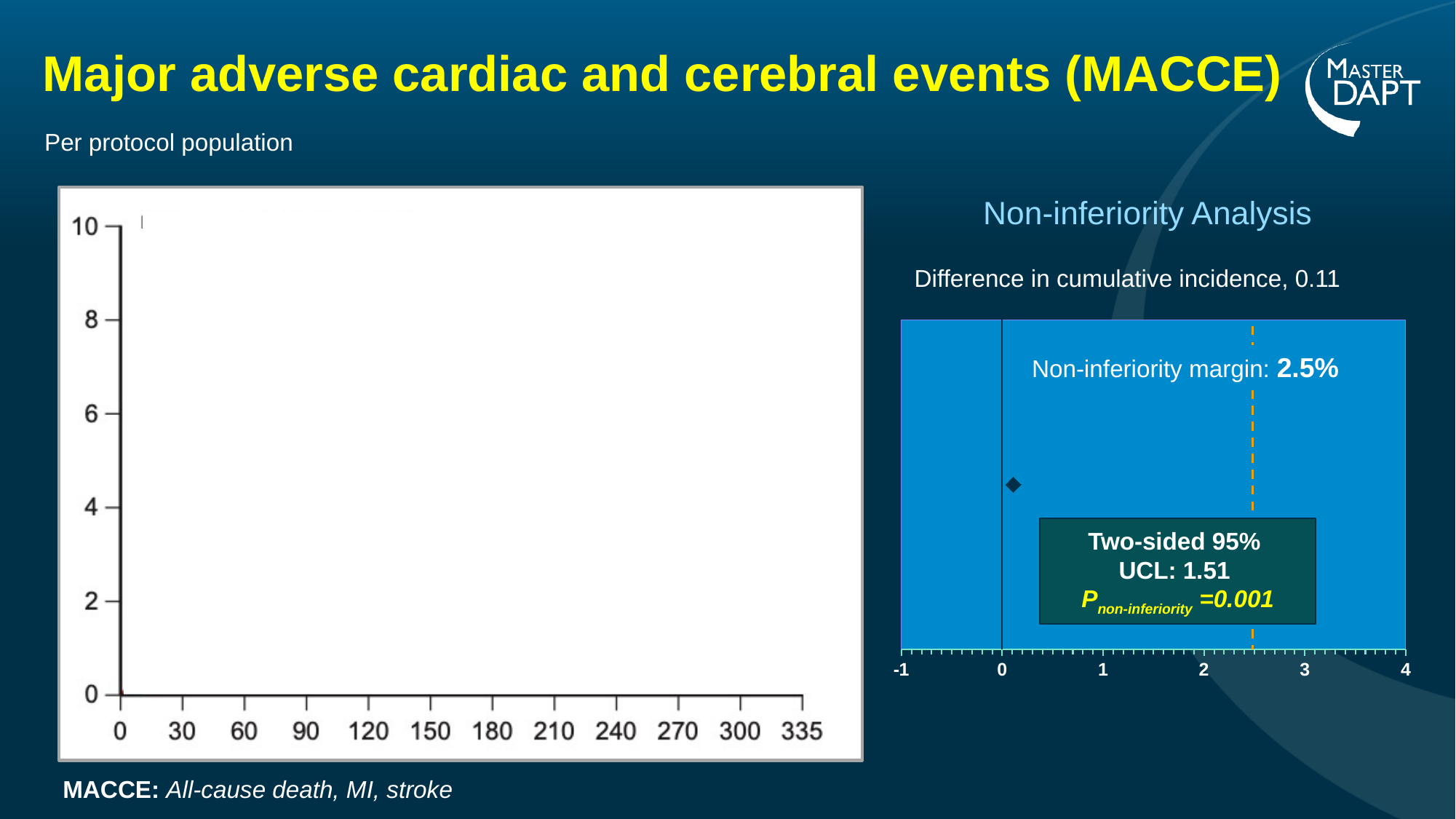
On the left chart, how many tick labels are shown on the x axis? 12 On the Non-inferiority Analysis chart, what is the non-inferiority margin? 2.5% On the Non-inferiority Analysis chart, what is the difference in cumulative incidence shown? 0.11 On the Non-inferiority Analysis chart, what is the two-sided 95% upper confidence limit (UCL)? 1.51 On the left chart, what is the highest value labelled on the y axis? 10 On the Non-inferiority Analysis chart, what are the lowest and highest values labelled on the x axis? -1 and 4 On the left chart, what is the last value labelled on the x axis? 335 On the Non-inferiority Analysis chart, is the plotted point estimate greater or less than 1 on the x axis? less On the Non-inferiority Analysis chart, is the two-sided 95% UCL of 1.51 greater or less than the non-inferiority margin of 2.5%? less On the Non-inferiority Analysis chart, what is the difference between the non-inferiority margin (2.5) and the UCL (1.51)? 0.99 On the Non-inferiority Analysis chart, how is the non-inferiority margin marked? A dashed vertical line at 2.5 On the Non-inferiority Analysis chart, what is the P value for non-inferiority? 0.001